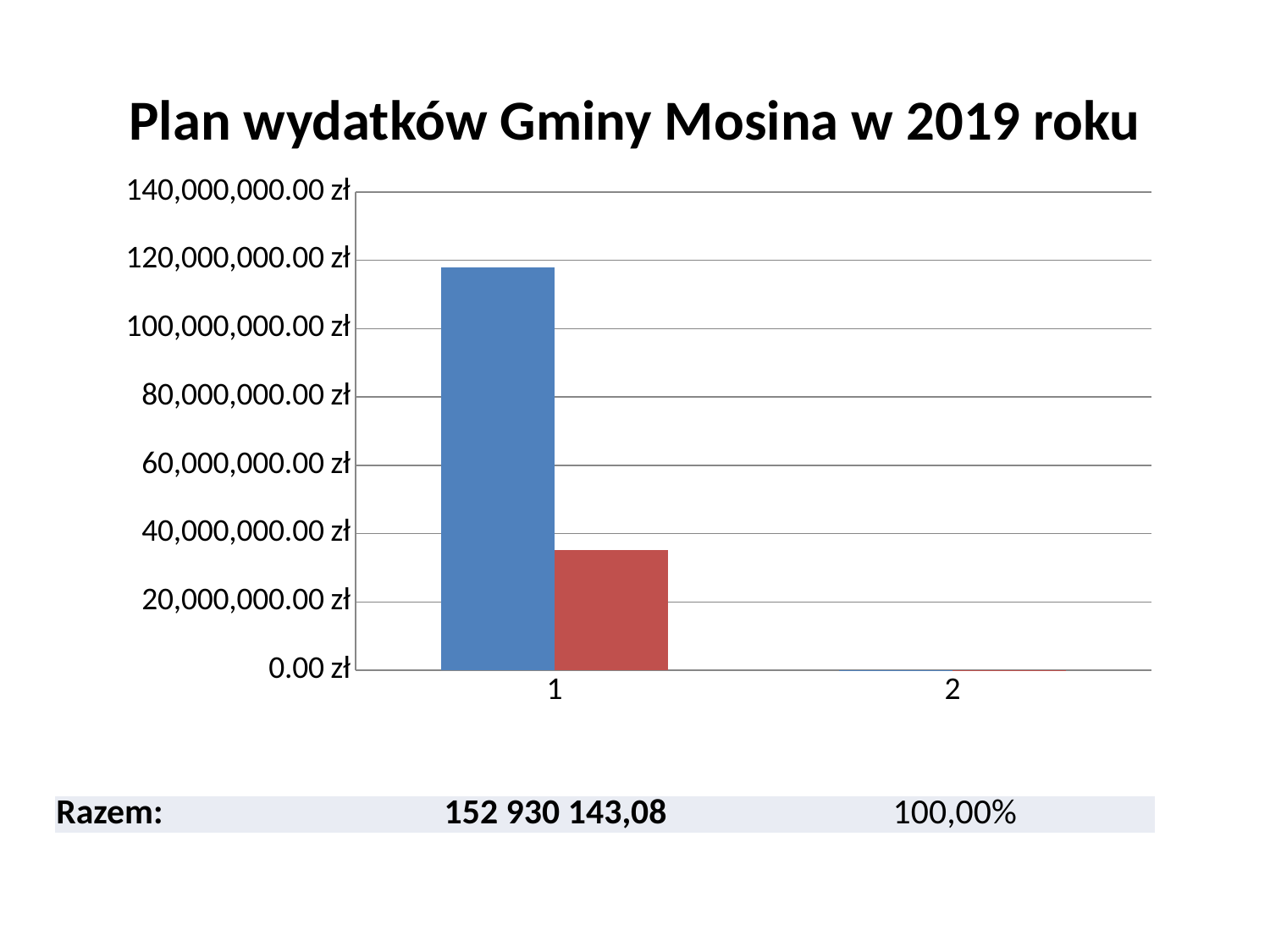
What kind of chart is shown on the slide? bar chart Do the values rise or fall from category 1 to category 2? fall Is the value of the red bar for category 1 greater or less than 20,000,000.00 zł? greater What is the title of the chart? Plan wydatków Gminy Mosina w 2019 roku How many categories are shown on the x axis of the chart? 2 Is the value of the blue bar for category 1 greater or less than 100,000,000.00 zł? greater For category 1, which bar is larger, the blue one or the red one? the blue one How many bars are plotted for category 1? 2 Is the value of the blue bar for category 1 greater or less than 120,000,000.00 zł? less Which category has the tallest bar in the chart? 1